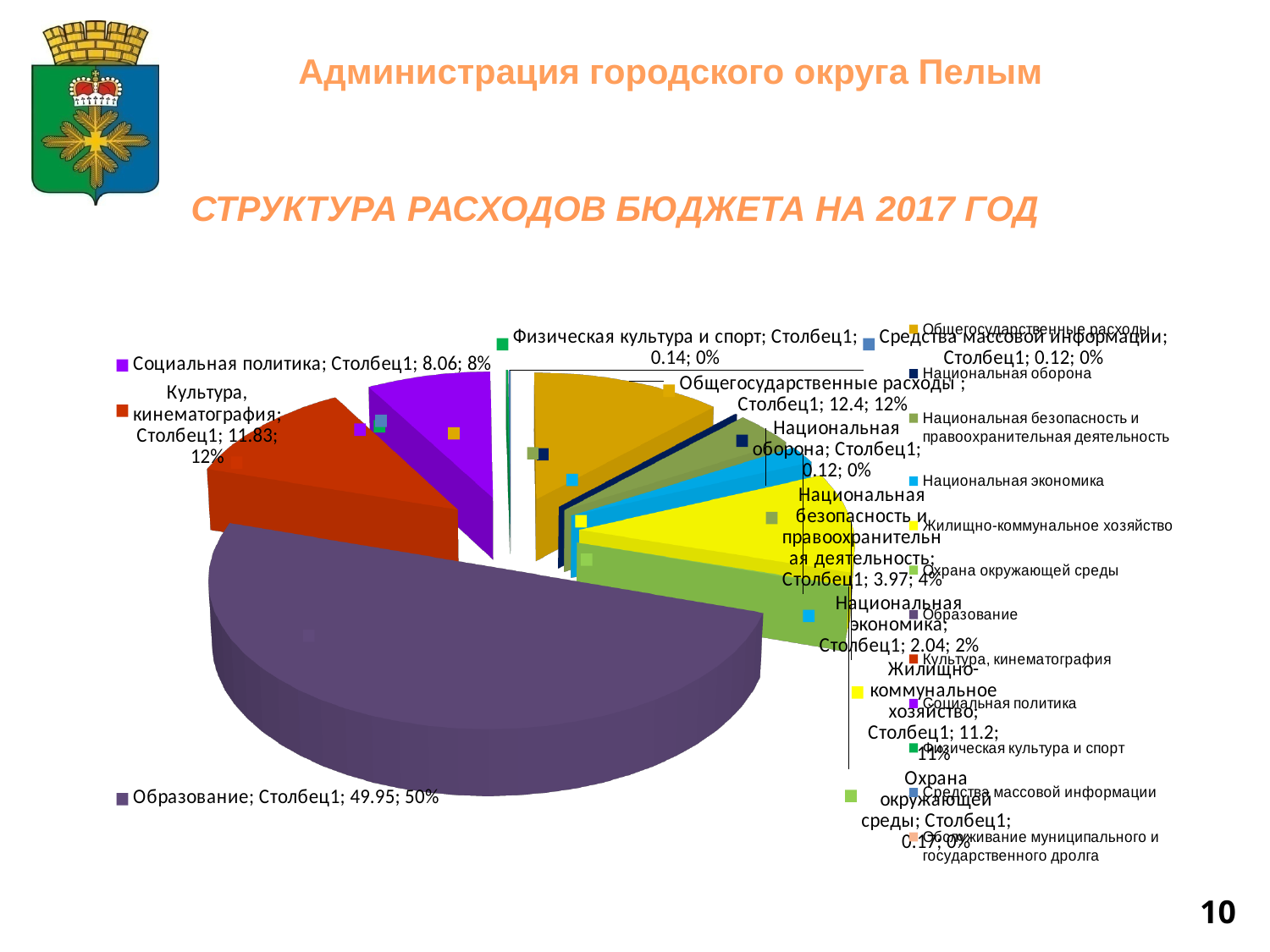
What is the value for Образование? 49.95 What is the value for Социальная политика? 8.06 What kind of chart is shown on the slide? pie chart What is the difference between the values for Образование and Социальная политика? 41.89 What is the value for Культура, кинематография? 11.83 What share of the pie does Образование take? 50% What is the value for Национальная безопасность и правоохранительная деятельность? 3.97 What is the title of the chart? СТРУКТУРА РАСХОДОВ БЮДЖЕТА НА 2017 ГОД What is the value for Жилищно-коммунальное хозяйство? 11.2 Which is larger, Общегосударственные расходы or Национальная экономика? Общегосударственные расходы Which category has the largest slice of the pie? Образование What is the value for Общегосударственные расходы? 12.4